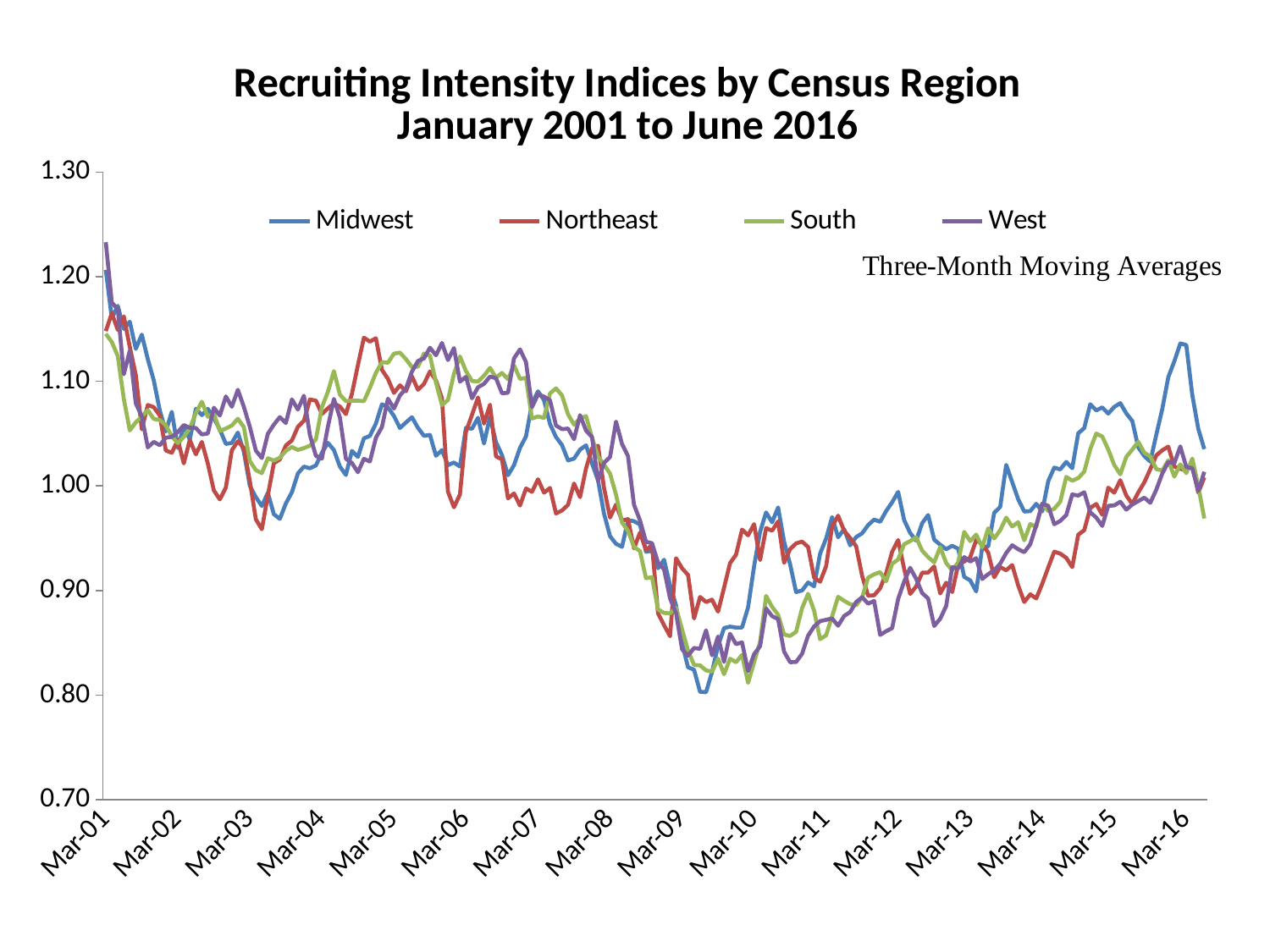
Which regions are listed in the legend? Midwest, Northeast, South, West Which series reaches the highest value in 2016? Midwest What kind of chart is shown on the slide? line chart Is the Midwest value at its lowest point around 2009 greater or less than 0.90? less How many series does the legend list? 4 Is the West value at Mar-01 greater or less than 1.20? greater Around Mar-10, which series is higher: Northeast or West? Northeast Is the West value around Mar-10 greater or less than 0.90? less Do the series generally rise or fall between Mar-08 and Mar-09? fall Around Mar-12, which series is higher: Midwest or West? Midwest What note appears below the legend describing how the series are smoothed? Three-Month Moving Averages